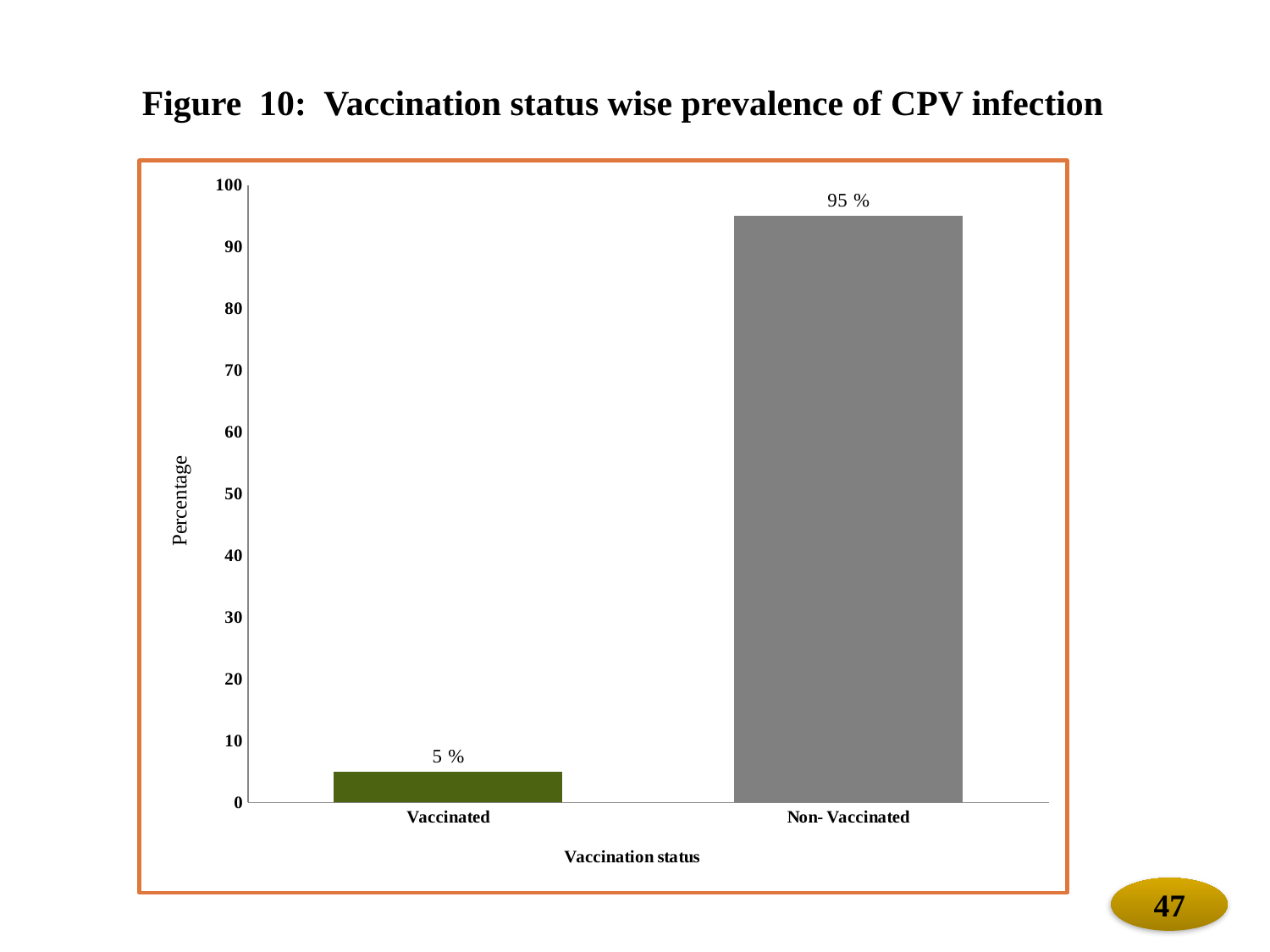
How many categories are shown on the x axis? 2 Which is larger, the value for Vaccinated or the value for Non- Vaccinated? Non- Vaccinated Which category has the highest value? Non- Vaccinated What is the label of the y axis? Percentage What is the difference between the values for Non- Vaccinated and Vaccinated? 90 % What is the value for Non- Vaccinated? 95 % Which category has the lowest value? Vaccinated What is the title of the figure on the slide? Figure 10: Vaccination status wise prevalence of CPV infection What is the value for Vaccinated? 5 % What kind of chart is shown on the slide? bar chart Is the value for Non- Vaccinated greater or less than 90? greater Is the value for Vaccinated greater or less than 10? less